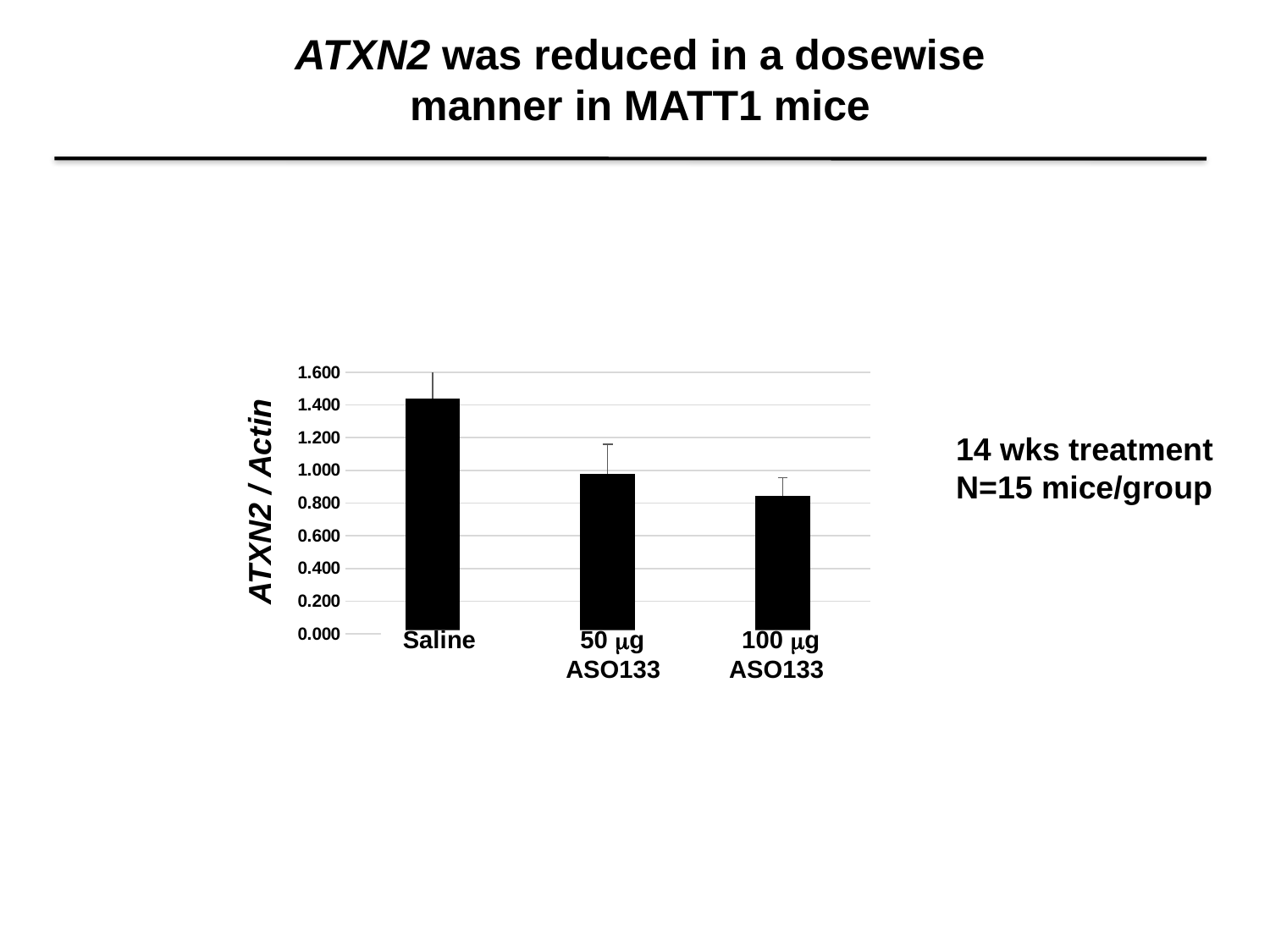
Is the value for 50 µg ASO133 greater or less than 0.800? greater What kind of chart is shown on the slide? bar chart Do the ATXN2 / Actin values rise or fall from Saline to 100 µg ASO133 along the x axis? fall How many categories are plotted on the x axis of the chart? 3 Is the value for 100 µg ASO133 greater or less than 1.000? less Which category has the highest ATXN2 / Actin value? Saline What is the label on the y axis of the chart? ATXN2 / Actin Which category has the lowest ATXN2 / Actin value? 100 µg ASO133 Is the value for 100 µg ASO133 greater or less than 0.600? greater What is the title of the slide containing the chart? ATXN2 was reduced in a dosewise manner in MATT1 mice Which is larger, the value for Saline or the value for 50 µg ASO133? Saline